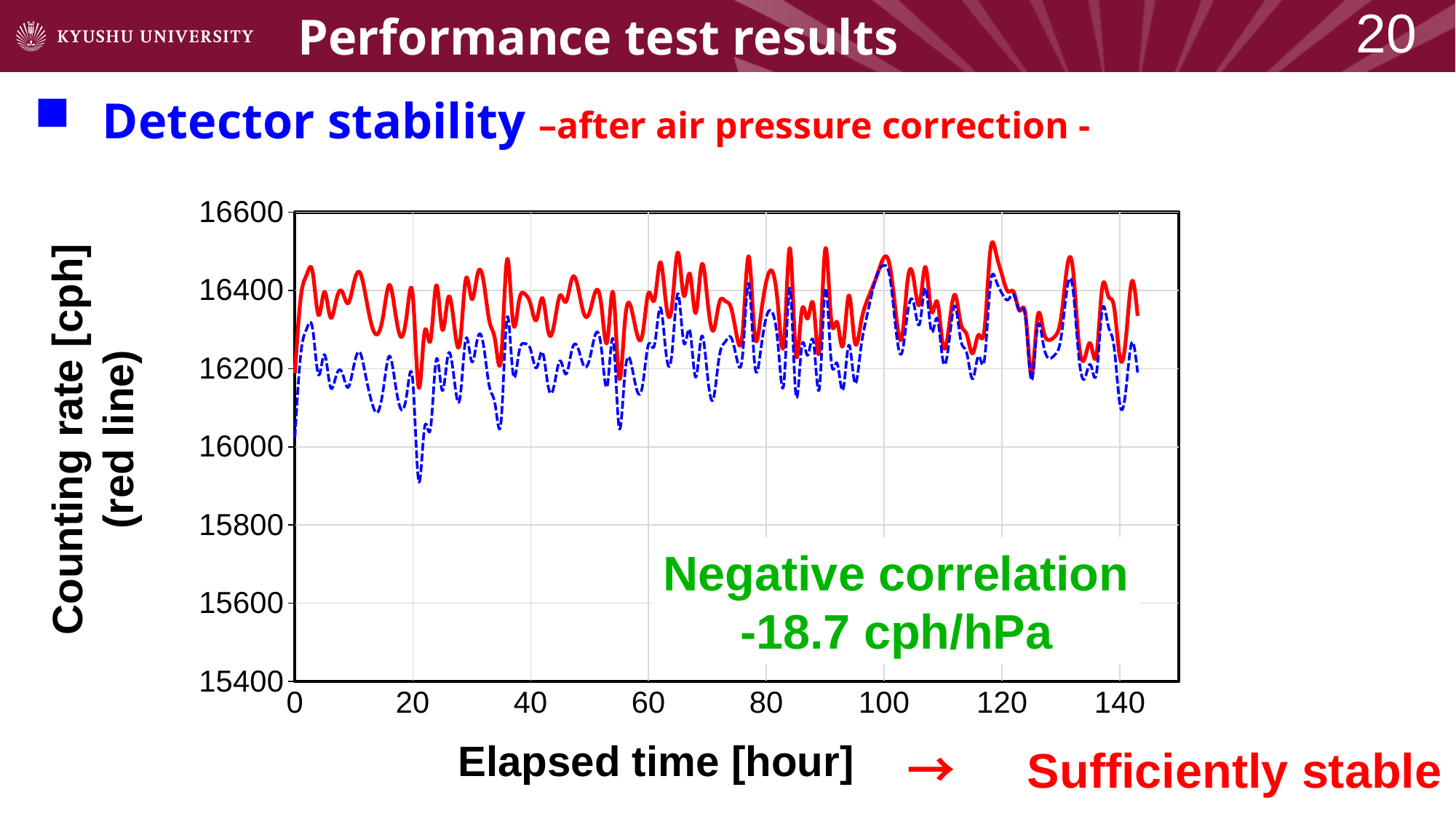
Is the lowest value of the red line, near 20 hours, greater or less than 16000? greater Is the highest value of the red line greater or less than 16600? less Which line is generally higher over the first 60 hours, the red solid line or the blue dashed line? red solid line What is the label of the y axis of the chart? Counting rate [cph] (red line) What is the label of the x axis of the chart? Elapsed time [hour] Does the red line ever drop below 16000 cph over the plotted time range? No What is the maximum value shown on the y axis? 16600 What kind of chart is shown on the slide? line chart